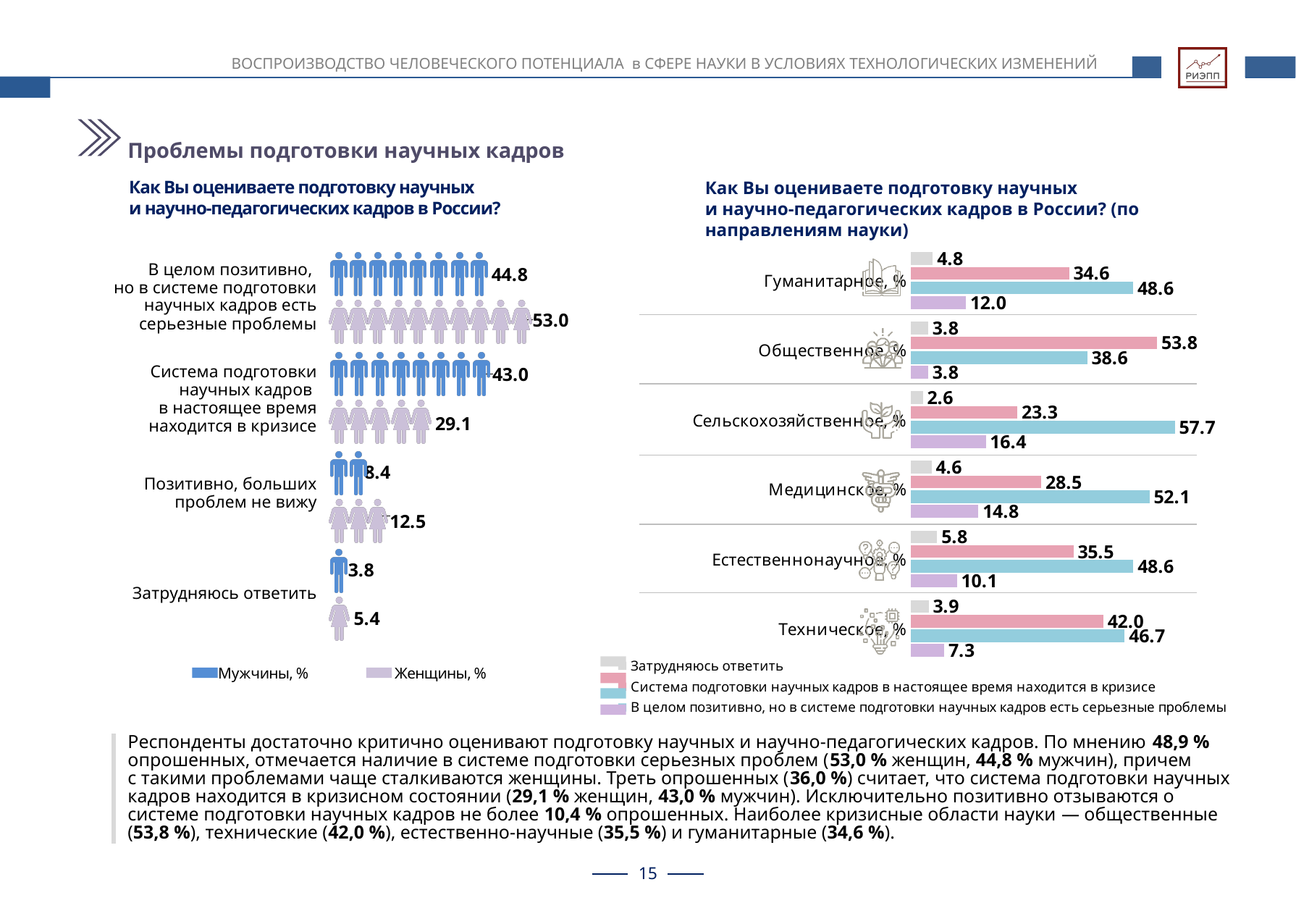
How many directions of science are shown in the right chart? 6 In the left chart, which is larger for 'Затрудняюсь ответить': the men's value or the women's value? Women (Женщины), 5.4 In the right chart, what is the difference between the light blue bar and the pink bar for Техническое? 4.7 In the right chart, which direction of science has the lowest value for the grey 'Затрудняюсь ответить' series? Сельскохозяйственное In the right chart, which direction of science has the highest value for the pink 'находится в кризисе' series? Общественное In the left chart, what is the difference between the women's and men's values for 'В целом позитивно, но в системе подготовки научных кадров есть серьезные проблемы'? 8.2 What type of chart is the right chart? Bar chart In the left chart, what is the value for women (Женщины) for 'Позитивно, больших проблем не вижу'? 12.5 In the right chart, what is the value of the light blue bar for Сельскохозяйственное? 57.7 In the left chart, what is the value for men (Мужчины) for 'Система подготовки научных кадров в настоящее время находится в кризисе'? 43.0 How many series does the legend of the left chart list? 2 In the right chart (by direction of science), what is the value of the pink 'Система подготовки научных кадров в настоящее время находится в кризисе' bar for Общественное? 53.8